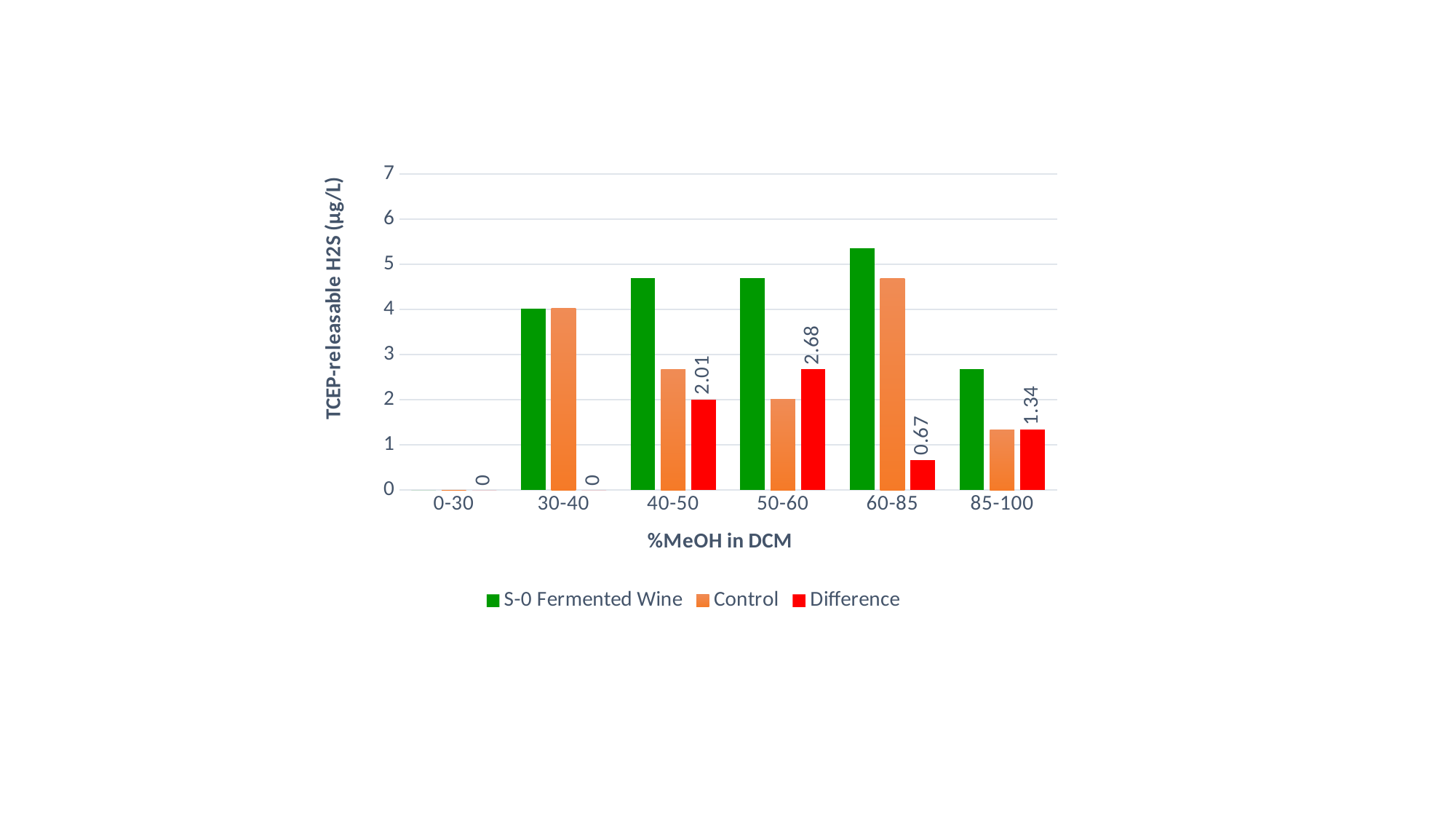
Is the S-0 Fermented Wine value for 60-85 greater or less than 5? greater In the 40-50 category, which is larger: S-0 Fermented Wine or Control? S-0 Fermented Wine What is the Difference value for the 40-50 %MeOH in DCM category? 2.01 What is the Difference value for the 60-85 category? 0.67 What kind of chart is shown on the slide? Bar chart How many %MeOH in DCM categories are shown on the x axis? 6 What is the Difference value for the 85-100 category? 1.34 Which category has the highest S-0 Fermented Wine value? 60-85 How much larger is the Difference value for 50-60 than for 40-50? 0.67 How many series does the legend list? 3 What is the Difference value for the 50-60 category? 2.68 Which %MeOH in DCM category has the highest Difference value? 50-60